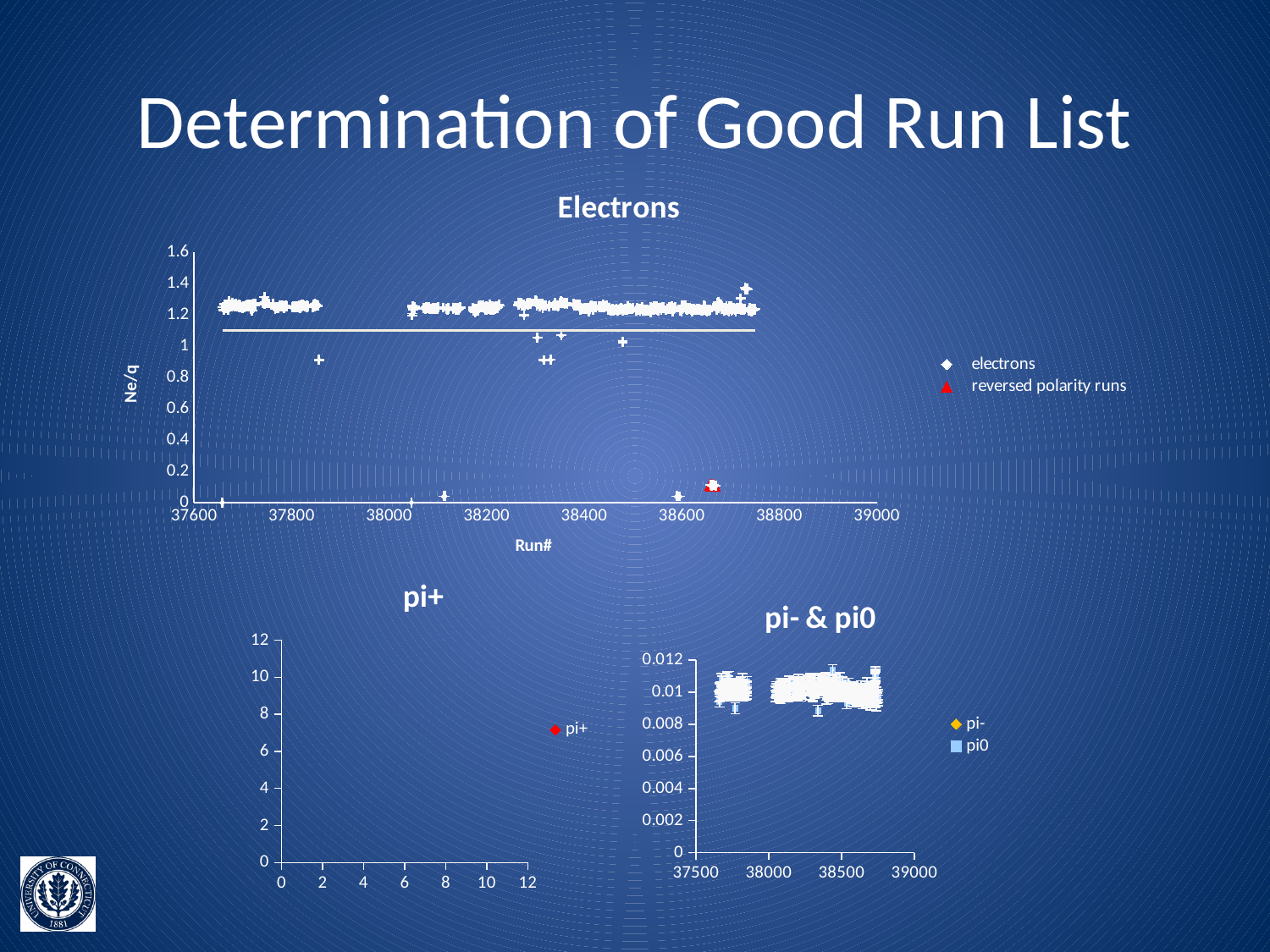
In the "pi- & pi0" chart, are the plotted values greater or less than 0.008? greater In the "pi- & pi0" chart, are the plotted values greater or less than 0.012? less How many series does the legend of the "pi+" chart list? 1 How many series does the legend of the "Electrons" chart list? 2 What is the highest tick value on the y-axis of the "pi+" chart? 12 What is the y-axis label of the "Electrons" chart? Ne/q In the "Electrons" chart, are the reversed polarity run points near run 38650 greater or less than 0.2? less What are the two series named in the legend of the "Electrons" chart? electrons, reversed polarity runs What kind of chart is the "Electrons" chart? scatter chart How many series does the legend of the "pi- & pi0" chart list? 2